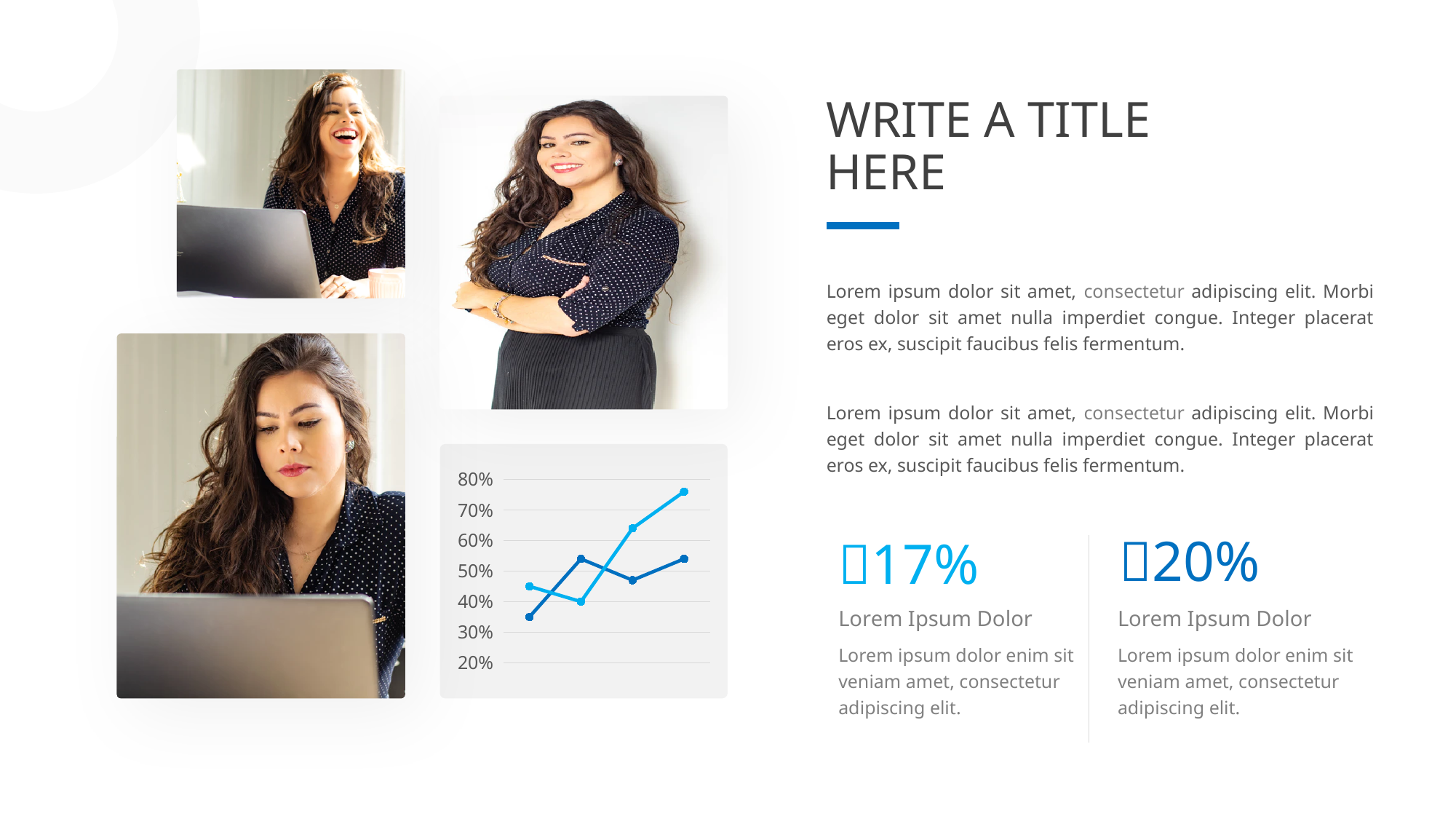
How many lines are plotted on the chart? 2 What is the lowest value shown on the chart's vertical axis? 20% How many data points does the light blue line have? 4 At the last data point, which line is higher, the light blue or the dark blue? light blue Is the third point of the light blue line greater or less than 60%? greater Does the light blue line end higher or lower than it starts? higher At the first data point, which line is higher, the light blue or the dark blue? light blue Is the last point of the dark blue line greater or less than 60%? less What is the highest value shown on the chart's vertical axis? 80% Is the last point of the light blue line greater or less than 70%? greater What kind of chart is shown on the slide? line chart